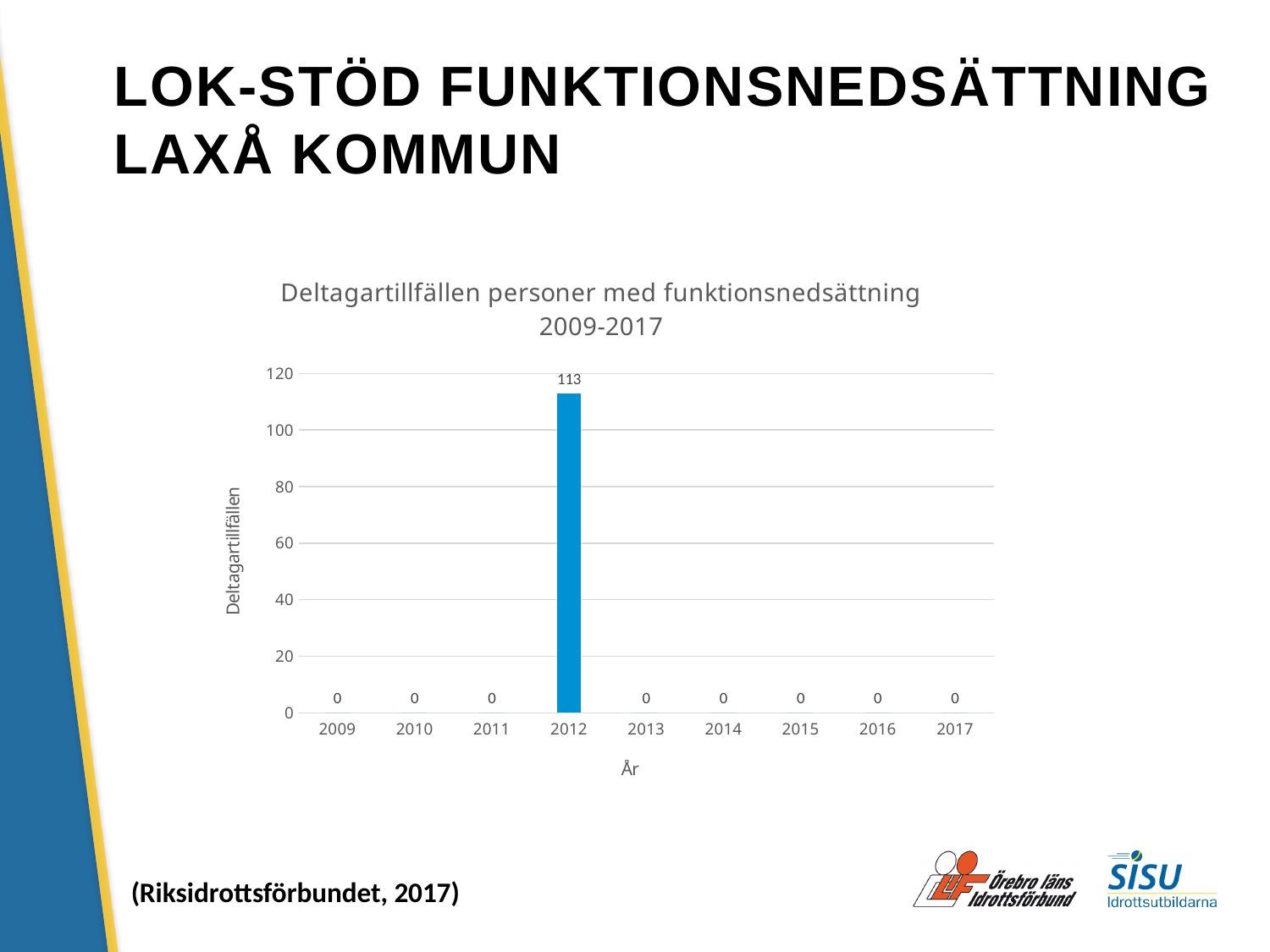
What is the difference between the values for 2012 and 2013? 113 Which is larger, the value for 2012 or the value for 2016? 2012 What is the title of the chart? Deltagartillfällen personer med funktionsnedsättning 2009-2017 How many years in the chart have a value of 0? 8 What is the value for 2015 in the chart? 0 What is the value for 2012 in the chart? 113 What is the value for 2009 in the chart? 0 What kind of chart is shown on the slide? bar chart How many years are shown on the x axis of the chart? 9 Which year has the highest value in the chart? 2012 What is the label of the y axis of the chart? Deltagartillfällen Is the value for 2012 greater or less than 100? greater